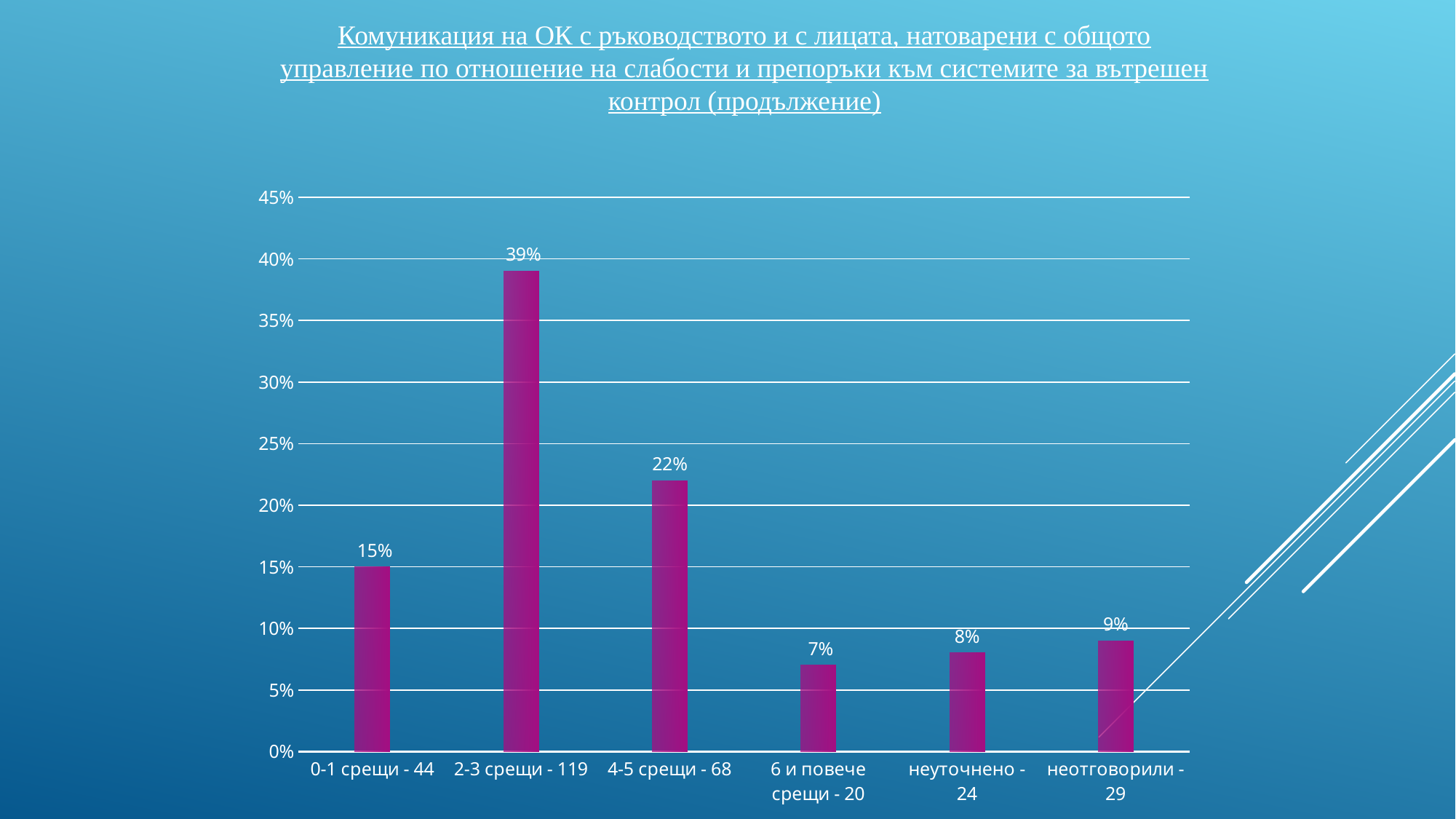
What colour are the bars in the chart? magenta (purple-pink) What is the value for the category "2-3 срещи - 119"? 39% Which is larger, the value for "0-1 срещи - 44" or the value for "неуточнено - 24"? 0-1 срещи - 44 What is the highest value shown on the vertical axis? 45% What kind of chart is shown on the slide? bar chart Which category has the highest value? 2-3 срещи - 119 How many categories are shown on the x axis? 6 Is the value for "4-5 срещи - 68" greater or less than 20%? greater Which category has the lowest value? 6 и повече срещи - 20 What is the difference between the values for "2-3 срещи - 119" and "4-5 срещи - 68"? 17% What is the value for the category "0-1 срещи - 44"? 15% What is the value for the category "неотговорили - 29"? 9%